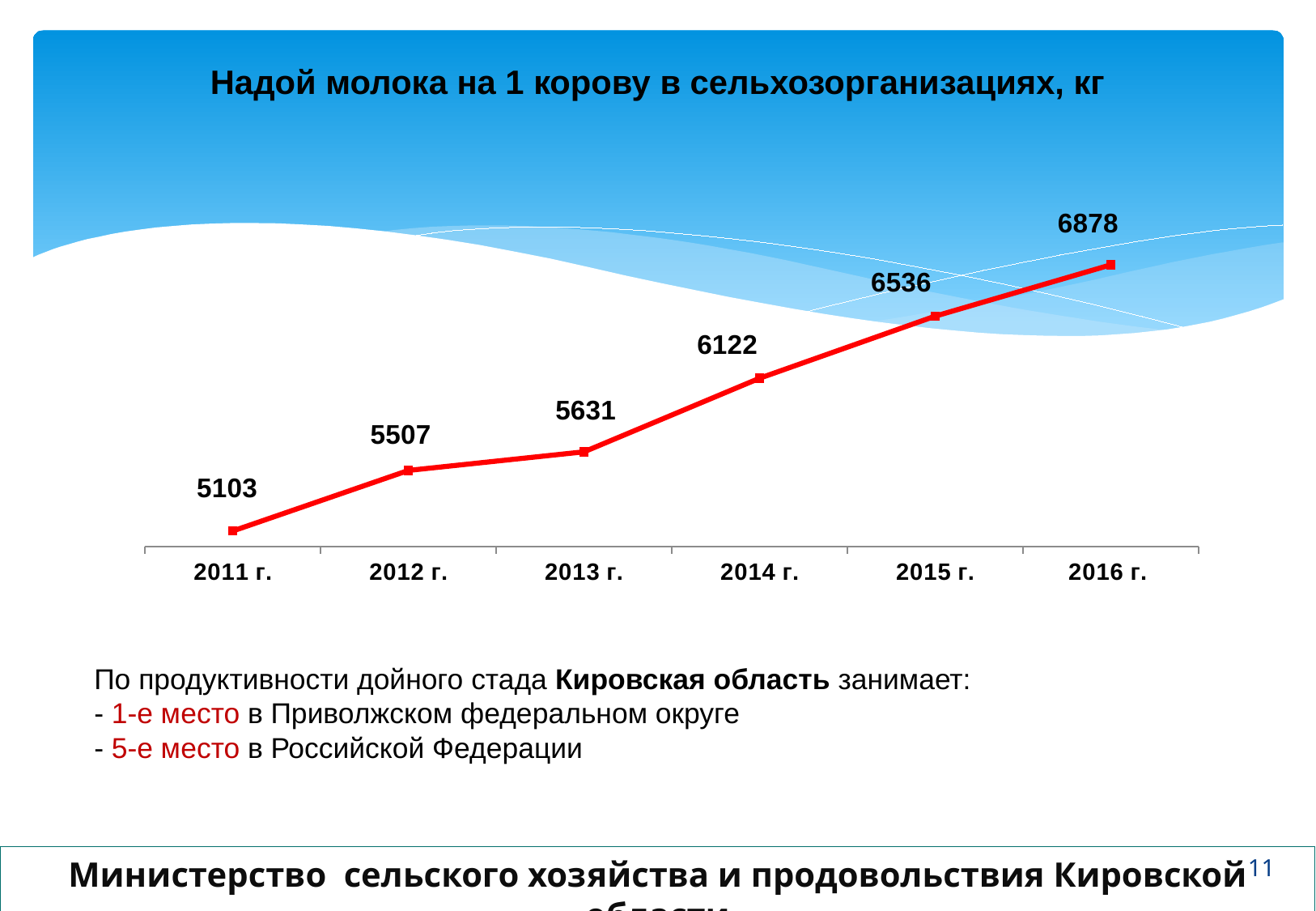
What is the milk yield per cow in 2014 г.? 6122 How many years are shown on the x axis? 6 Do the values rise or fall from 2011 г. to 2016 г.? rise What is the difference between the milk yield in 2016 г. and 2011 г.? 1775 What is the difference between the milk yield in 2013 г. and 2012 г.? 124 What kind of chart is shown on the slide? line chart Which year has the lowest milk yield per cow? 2011 г. What is the milk yield per cow in 2011 г.? 5103 Which year has the highest milk yield per cow? 2016 г. Which is larger, the milk yield in 2015 г. or in 2014 г.? 2015 г. What is the title of the chart? Надой молока на 1 корову в сельхозорганизациях, кг What is the milk yield per cow in 2016 г.? 6878